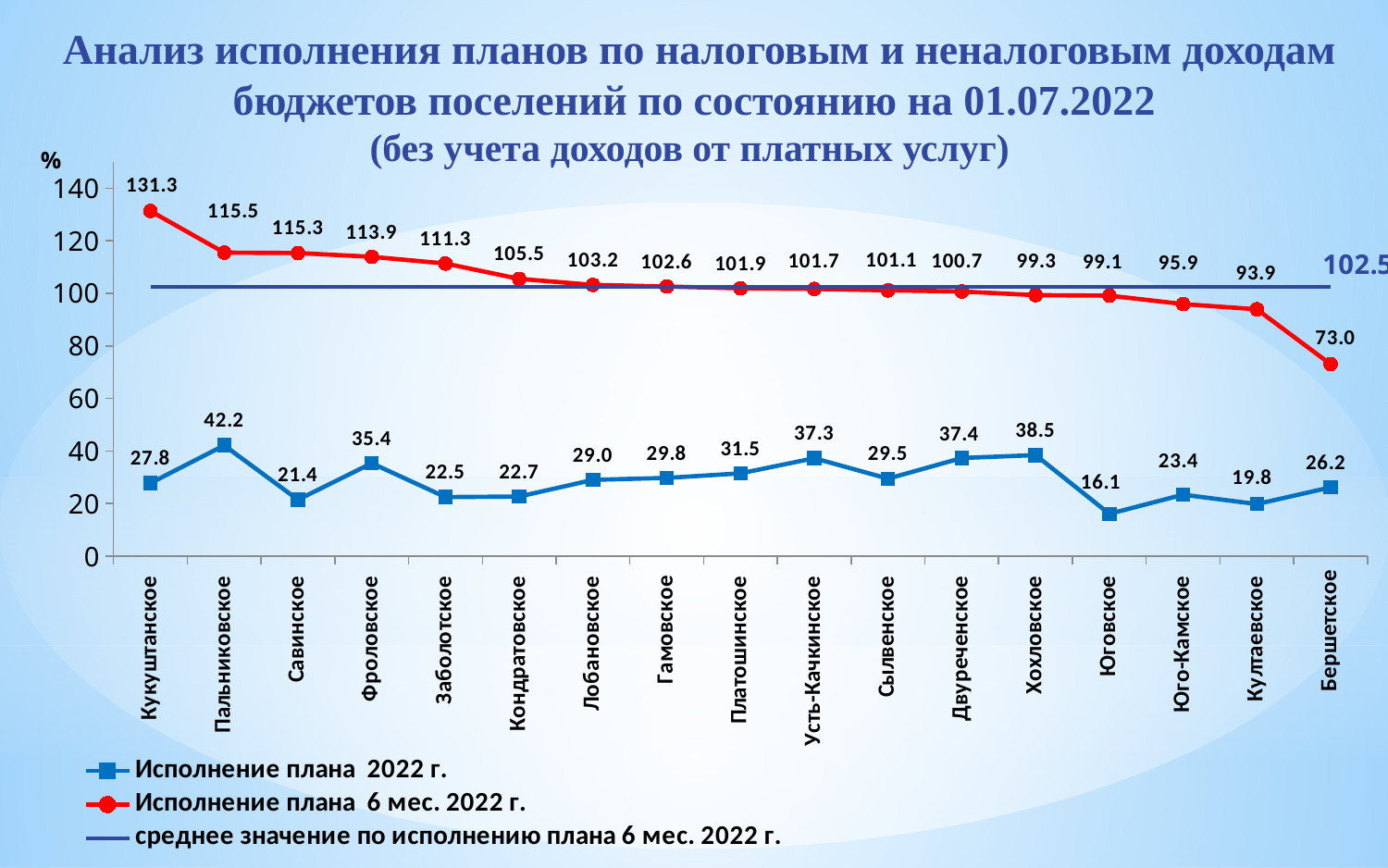
Which settlement has the lowest value in the 'Исполнение плана 6 мес. 2022 г.' series? Бершетское How many series does the legend list? 3 Which settlement has the lowest value in the 'Исполнение плана 2022 г.' series? Юговское What is the value of the 'Исполнение плана 2022 г.' series for Хохловское? 38.5 In the 'Исполнение плана 2022 г.' series, which is larger: Фроловское or Усть-Качкинское? Усть-Качкинское What kind of chart is shown on the slide? line chart Which settlement has the highest value in the 'Исполнение плана 2022 г.' series? Пальниковское What is the difference between the 'Исполнение плана 6 мес. 2022 г.' value and the 'Исполнение плана 2022 г.' value for Кукуштанское? 103.5 Does the 'Исполнение плана 6 мес. 2022 г.' series rise or fall from left to right along the x axis? falls Is the 'Исполнение плана 6 мес. 2022 г.' value for Бершетское greater or less than 80? less How many settlements are shown on the x axis of the chart? 17 What is the value of the 'Исполнение плана 6 мес. 2022 г.' series for Кукуштанское? 131.3